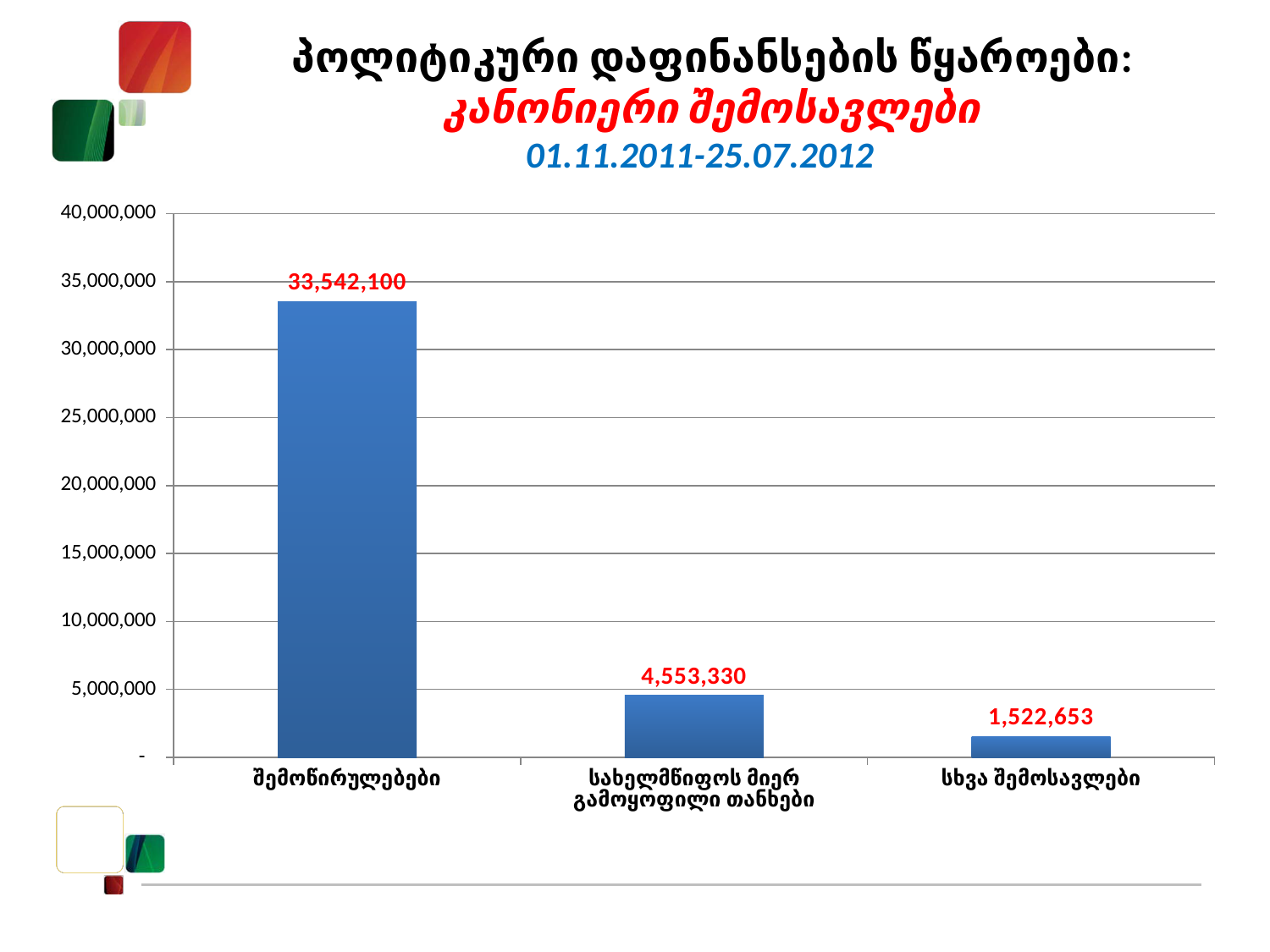
What is the value for სხვა შემოსავლები? 1,522,653 Which category has the lowest value? სხვა შემოსავლები What is the value for შემოწირულებები? 33,542,100 Which category has the highest value? შემოწირულებები What kind of chart is shown on the slide? bar chart What is the difference between the values for სახელმწიფოს მიერ გამოყოფილი თანხები and სხვა შემოსავლები? 3,030,677 What date range is shown in the slide title? 01.11.2011-25.07.2012 How many categories are shown on the x axis? 3 Is the value for შემოწირულებები greater or less than 30,000,000? greater What is the value for სახელმწიფოს მიერ გამოყოფილი თანხები? 4,553,330 Which is larger, the value for სახელმწიფოს მიერ გამოყოფილი თანხები or the value for სხვა შემოსავლები? სახელმწიფოს მიერ გამოყოფილი თანხები What is the difference between the values for შემოწირულებები and სახელმწიფოს მიერ გამოყოფილი თანხები? 28,988,770